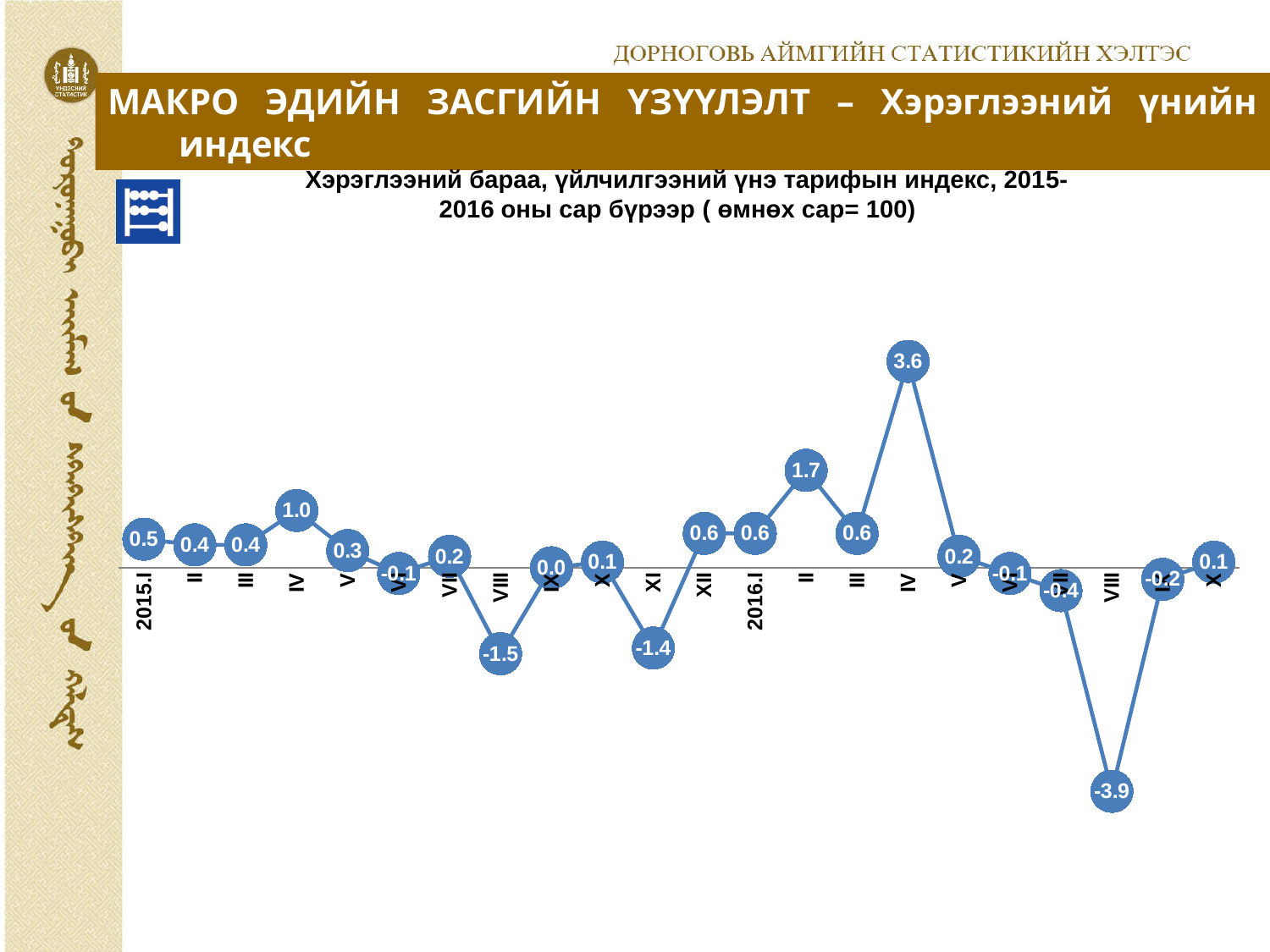
Which month has the highest value? 2016.IV What type of chart is shown on the slide? line chart What is the value for 2016.II? 1.7 Do the values rise or fall from 2016.IV to 2016.VIII? fall What is the value for 2015.VIII? -1.5 What is the difference between the values for 2016.IV and 2016.II? 1.9 What is the value for 2015.IV? 1.0 How many data points are plotted on the chart? 22 What is the value for 2016.IV? 3.6 Which month has the lowest value? 2016.VIII Which is larger, the value for 2015.XI or the value for 2015.VIII? 2015.XI What is the value for 2016.VIII? -3.9